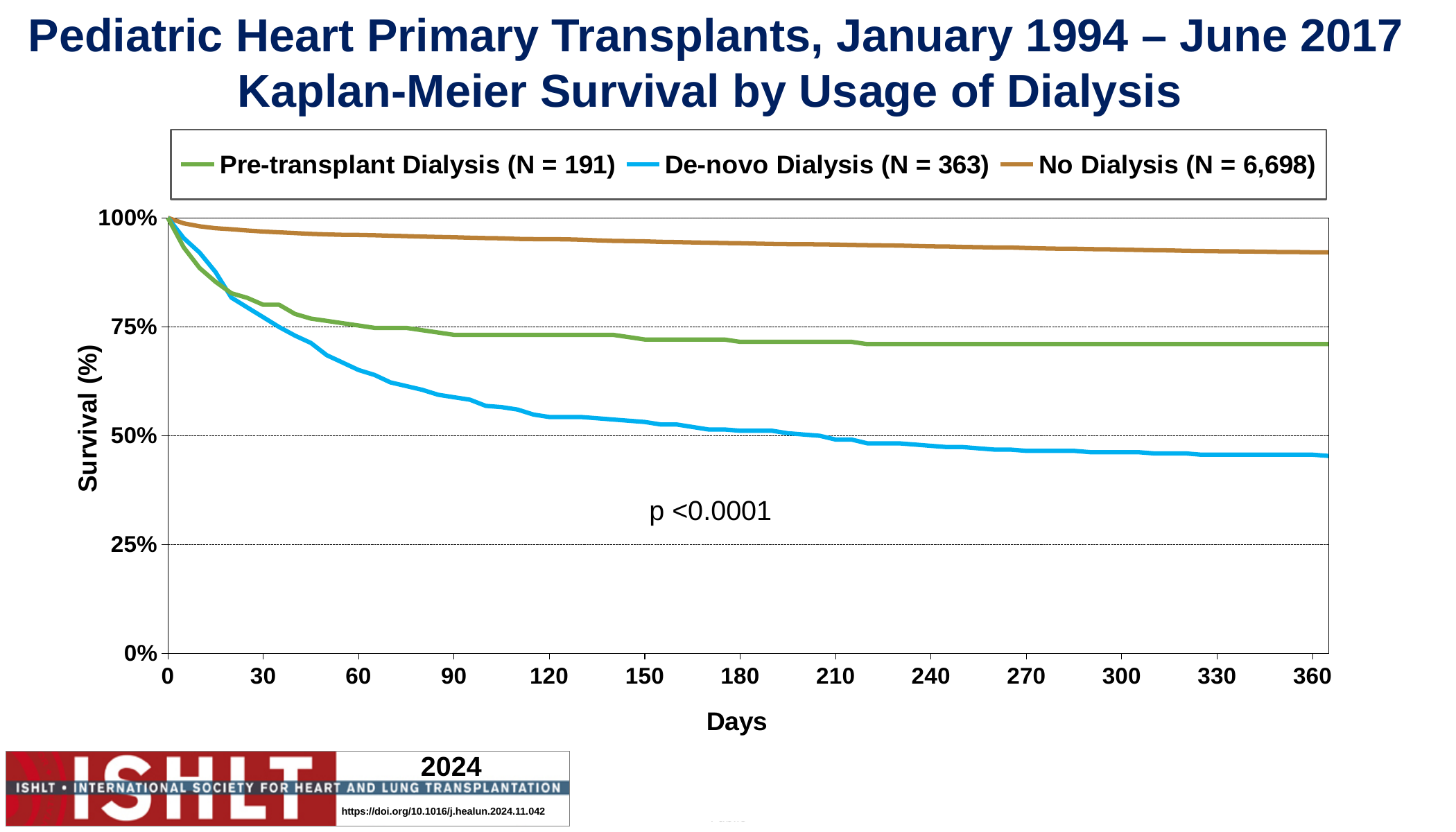
Is the survival for Pre-transplant Dialysis at 360 days greater or less than 75%? less Do the survival curves rise or fall as days increase? fall Is the survival for Pre-transplant Dialysis at 30 days greater or less than 75%? greater What is the N for the De-novo Dialysis group shown in the legend? 363 At 360 days, which group has higher survival: Pre-transplant Dialysis or De-novo Dialysis? Pre-transplant Dialysis Which group has the lowest survival at 360 days? De-novo Dialysis What p-value is printed on the chart? p <0.0001 Is the survival for De-novo Dialysis at 360 days greater or less than 50%? less What kind of chart is shown on the slide? line chart How many series does the legend list? 3 Which group has the highest survival at 360 days? No Dialysis